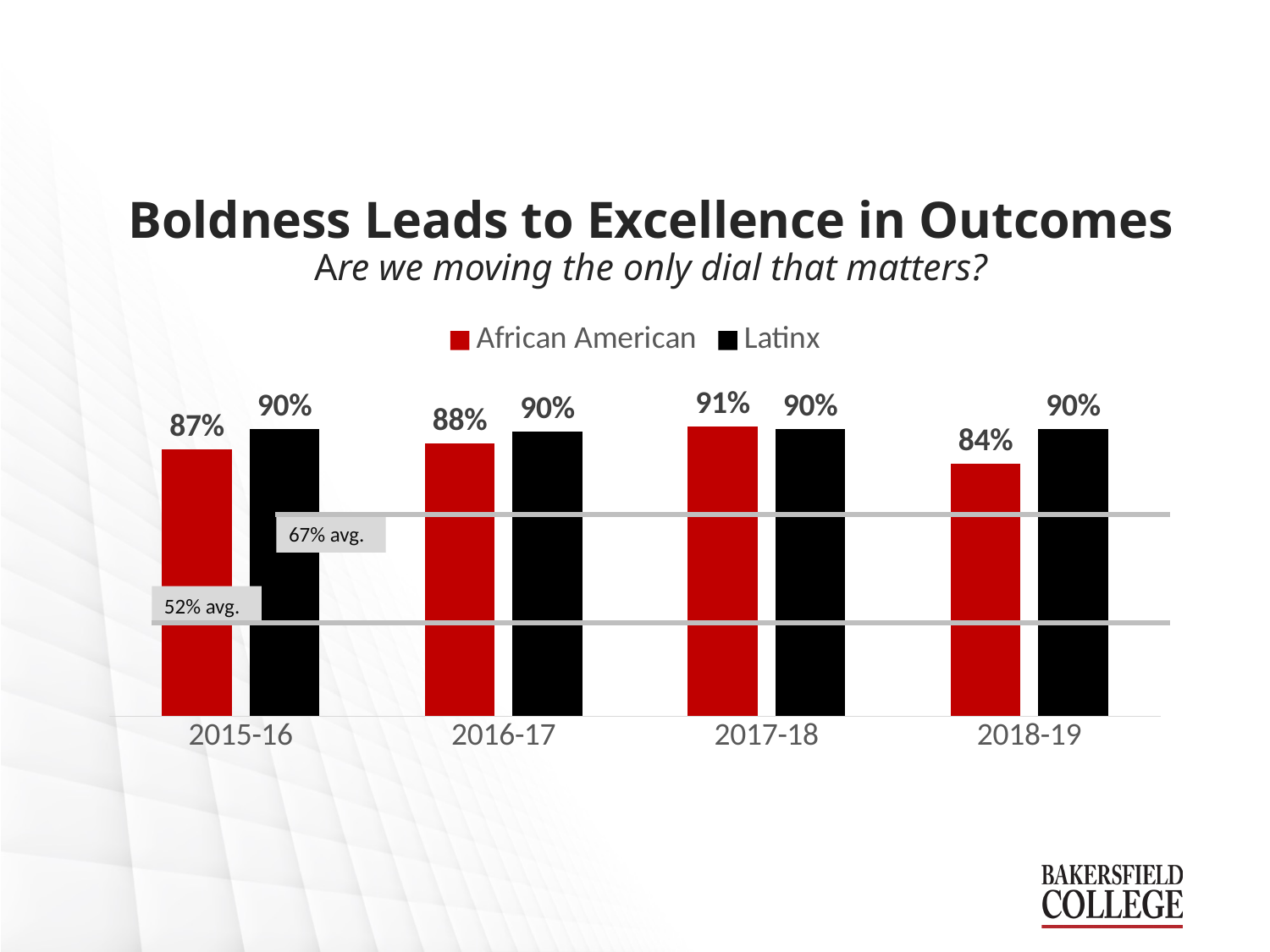
What kind of chart is shown on the slide? Bar chart Which is larger in 2017-18, the African American value or the Latinx value? African American How many years are shown on the x axis? 4 What is the value for Latinx in 2018-19? 90% What is the value for African American in 2017-18? 91% In which year is the African American value lowest? 2018-19 What is the value for African American in 2015-16? 87% In which year is the African American value highest? 2017-18 What colour represents the African American series? Red What is the difference between the Latinx and African American values in 2018-19? 6% How many series does the legend list? 2 Does the Latinx value change from 2015-16 to 2018-19? No, it stays at 90%